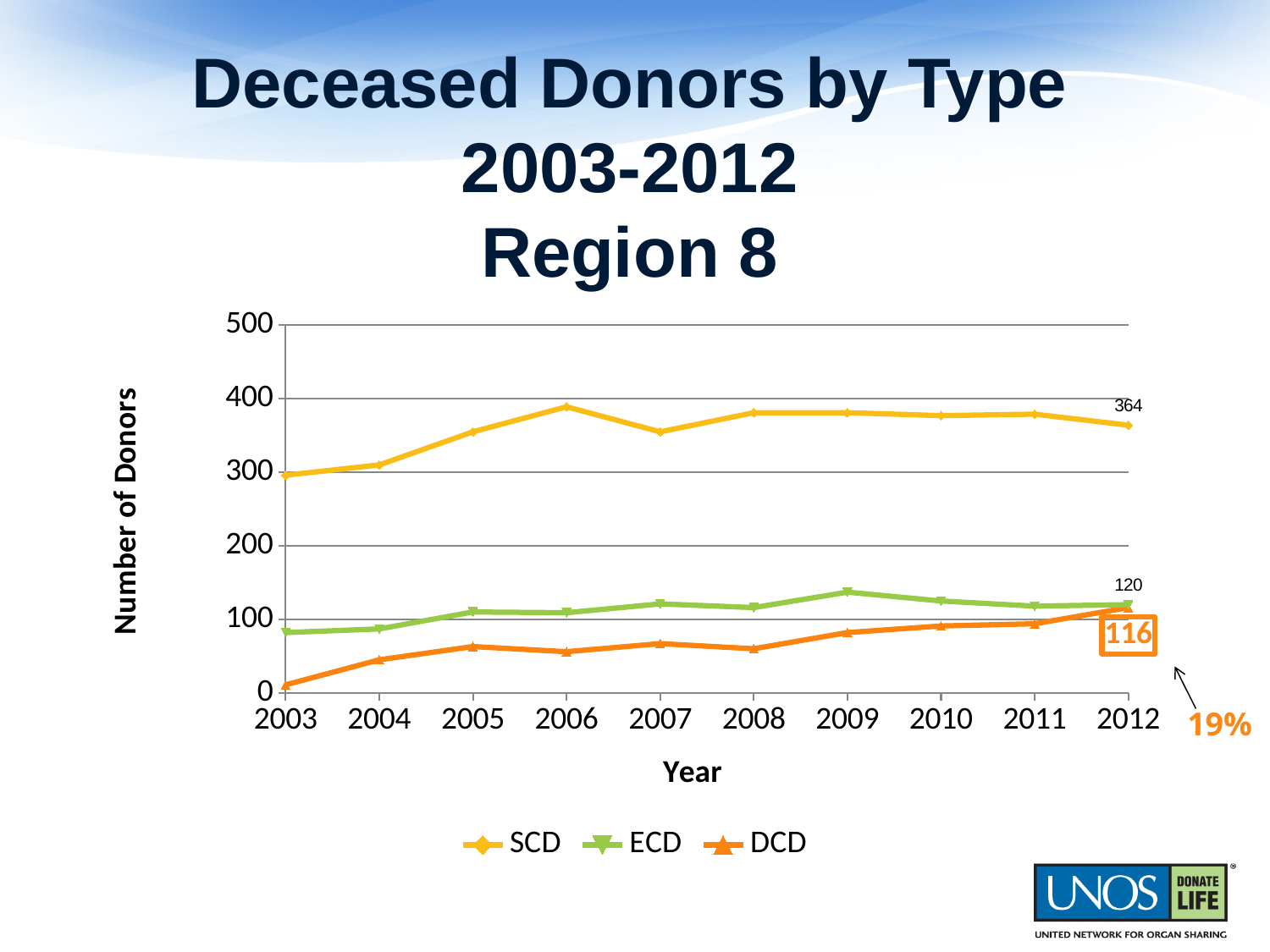
What kind of chart is shown on the slide? Line chart How many years are shown on the x axis? 10 What is the value for ECD in 2012? 120 Which series has the larger value in 2012, SCD or ECD? SCD What is the value for DCD in 2012? 116 Is the value for DCD in 2003 greater or less than 100? less How many series does the legend list? 3 What is the difference between the SCD and ECD values in 2012? 244 What is the difference between the ECD and DCD values in 2012? 4 What is the value for SCD in 2012? 364 In which year is the DCD value lowest? 2003 Is the value for SCD in 2006 greater or less than 300? greater